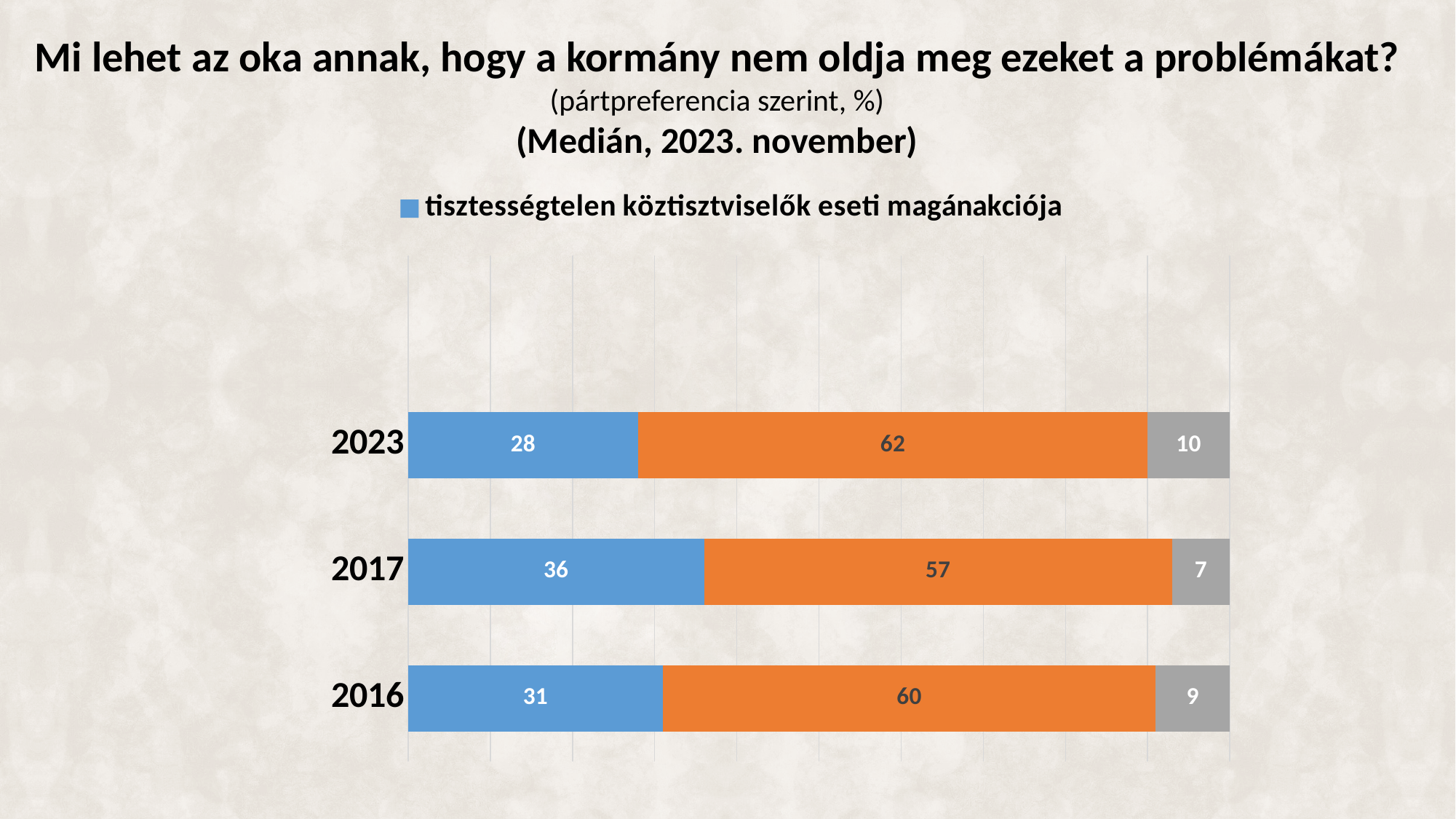
What is the difference between the orange segment values for 2023 and 2017? 5 In which year is the value for 'tisztességtelen köztisztviselők eseti magánakciója' highest? 2017 How many years (categories) are shown on the chart? 3 What kind of chart is shown on the slide? bar chart In which year is the value for 'tisztességtelen köztisztviselők eseti magánakciója' lowest? 2023 How many series does the legend list? 1 What is the value of the grey segment for 2023? 10 What is the total of the stacked bar for 2017? 100 What is the value of the orange segment for 2016? 60 Which is larger: the grey segment for 2016 or the grey segment for 2017? 2016 What is the value for 'tisztességtelen köztisztviselők eseti magánakciója' in 2017? 36 What is the value for 'tisztességtelen köztisztviselők eseti magánakciója' in 2023? 28